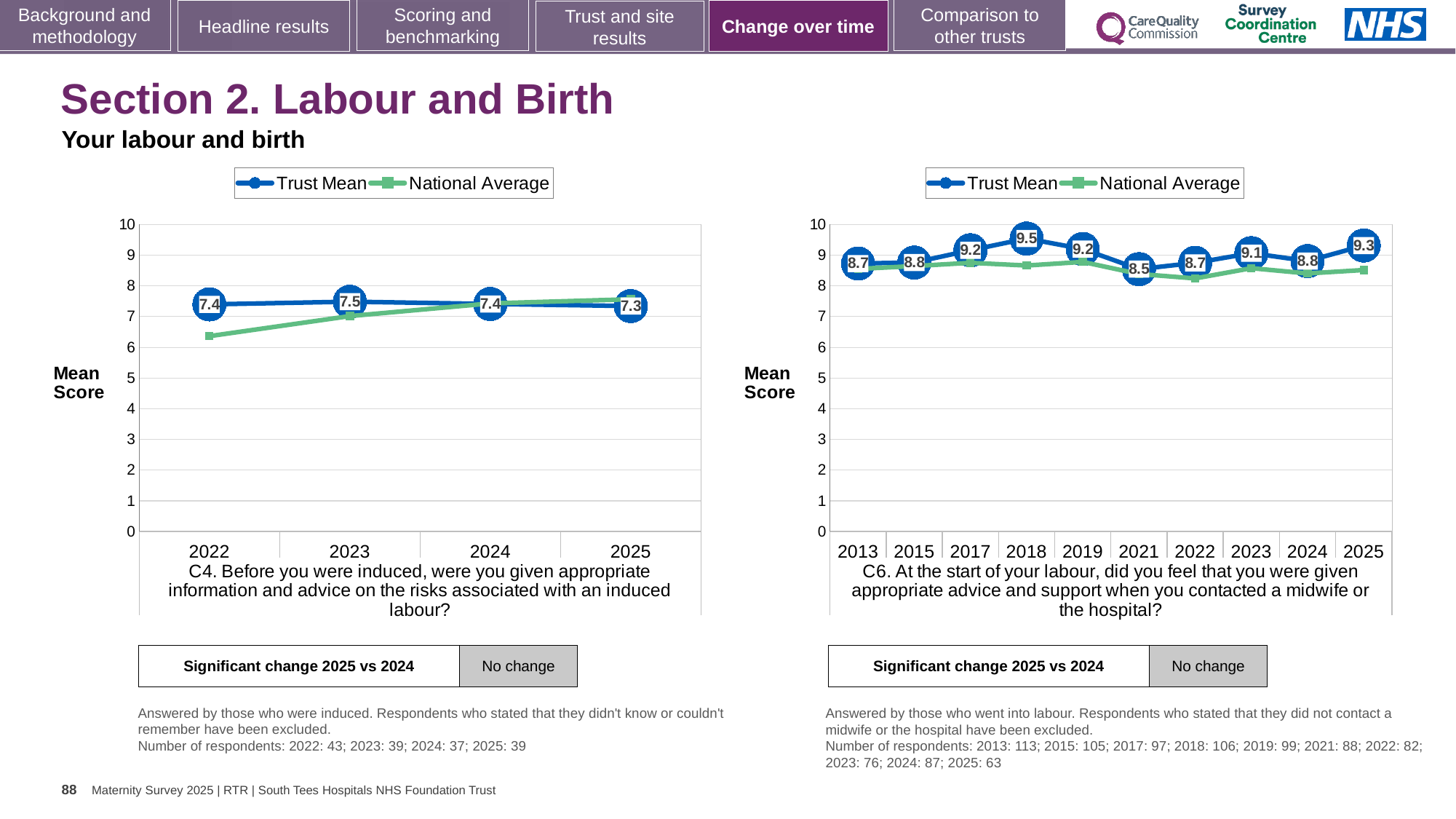
In the C6 chart (right), what is the difference between the Trust Mean scores for 2025 and 2024? 0.5 In the C6 chart (right), which year has the highest Trust Mean score? 2018 In the C4 chart (left), what is the Trust Mean score for 2025? 7.3 In the C6 chart (right), how many years are shown on the x axis? 10 In the C4 chart (left), is the National Average value for 2022 greater or less than 7? less How many series does the legend of the C6 chart (right) list? 2 In the C4 chart (left), which is larger in 2022, the Trust Mean or the National Average? Trust Mean In the C6 chart (right), which year has the lowest Trust Mean score? 2021 What type of chart is the C4 chart (left)? Line chart In the C4 chart (left), what is the Trust Mean score for 2023? 7.5 In the C6 chart (right), what is the Trust Mean score for 2018? 9.5 In the C4 chart (left), how many years are shown on the x axis? 4